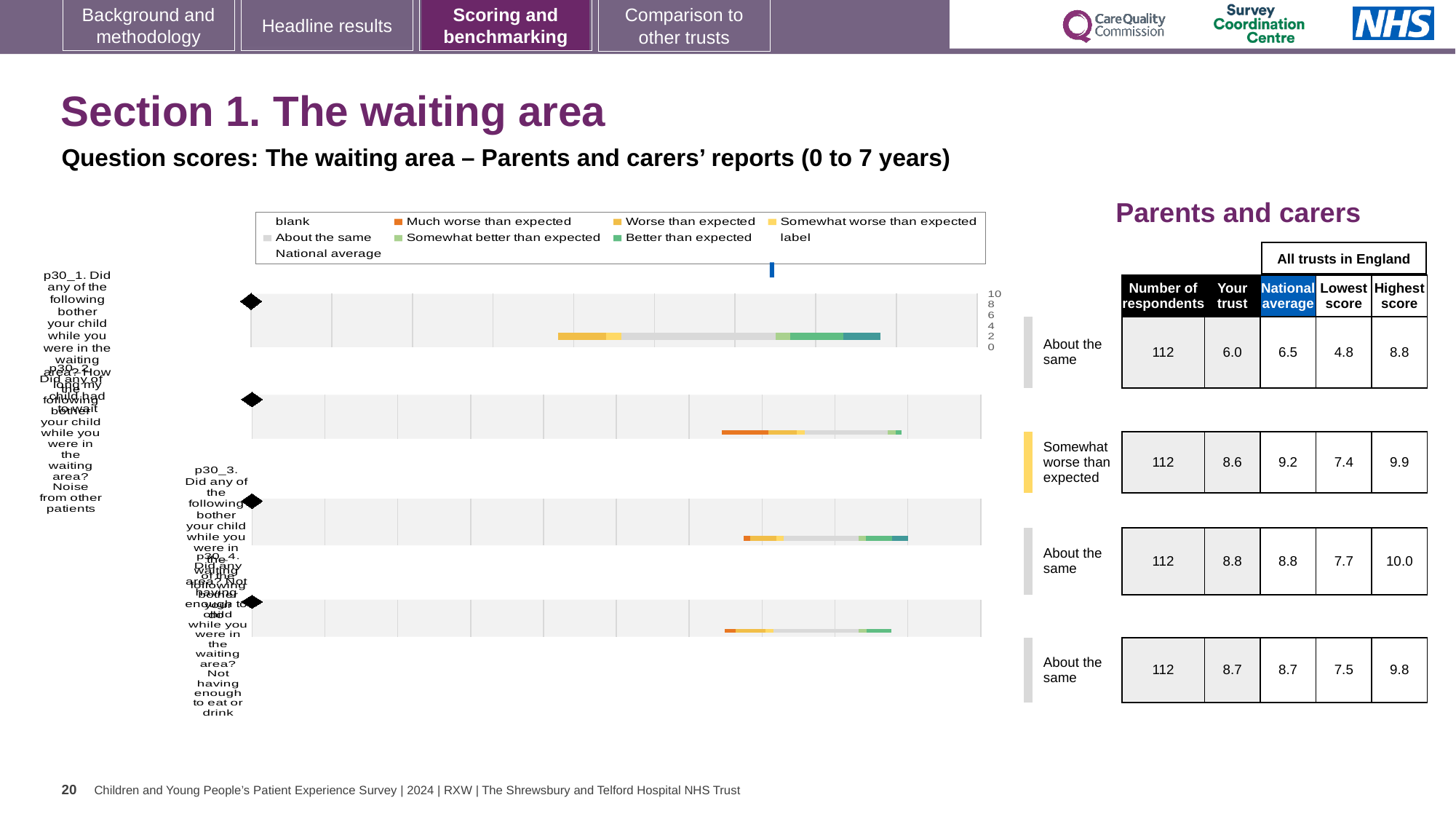
What is the national average score for p30_2 (Noise from other patients)? 9.2 How many entries does the chart legend list? 9 What is the difference between the national average and the 'Your trust' score for p30_1 (How long my child had to wait)? 0.5 Which question has the highest 'Your trust' score? p30_3. Not having enough to do What type of chart is used to show the question scores for the waiting area? bar chart What is the highest score across all trusts in England for p30_3 (Not having enough to do)? 10.0 For p30_2 (Noise from other patients), which is larger: the 'Your trust' score or the national average? National average What is the 'Your trust' score for p30_1 (How long my child had to wait)? 6.0 Which question has the lowest 'Your trust' score? p30_1. How long my child had to wait What is the lowest score across all trusts in England for p30_4 (Not having enough to eat or drink)? 7.5 How many questions (rows) are plotted in the waiting area chart? 4 How many respondents answered p30_1 (How long my child had to wait)? 112